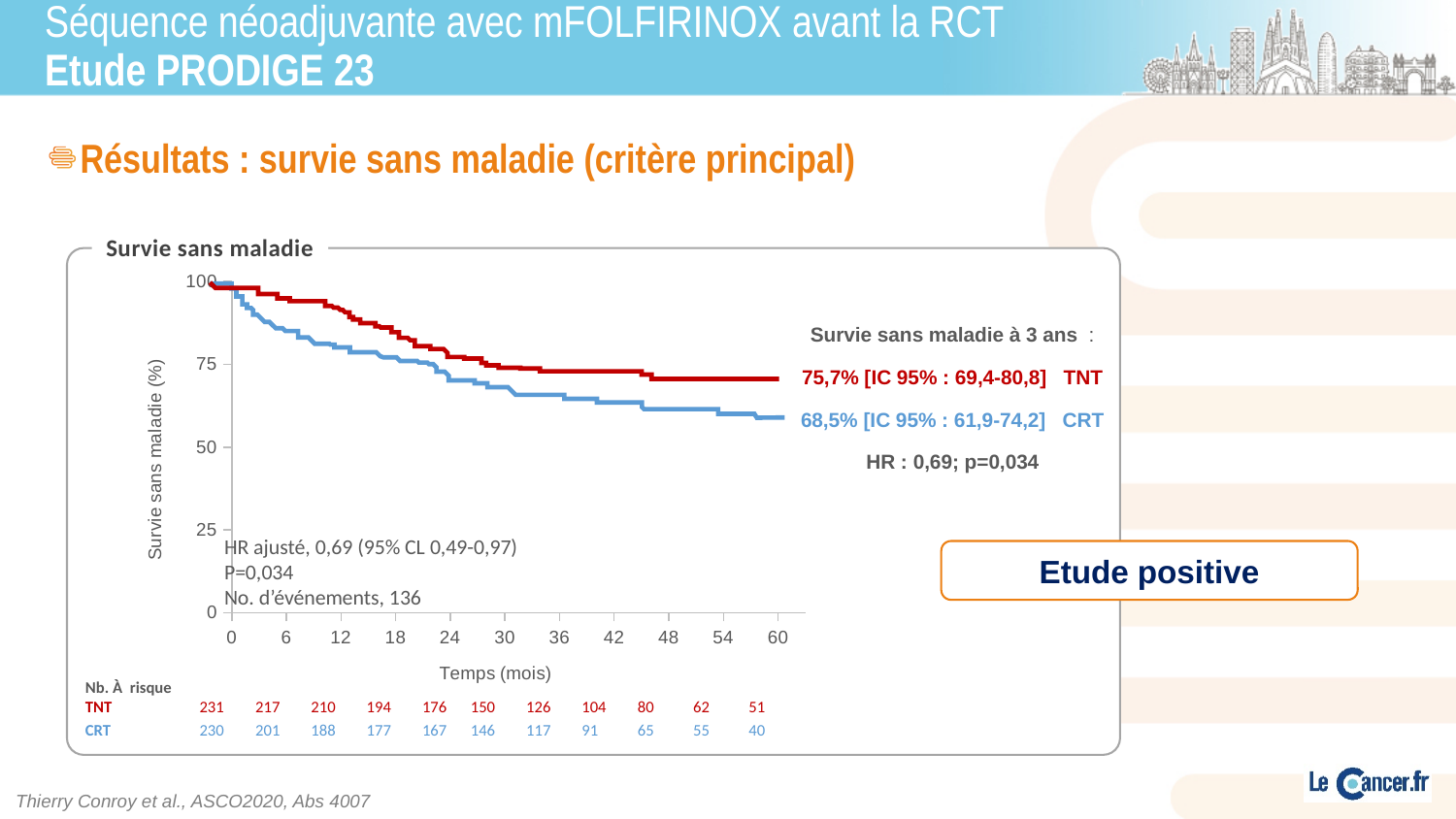
What is the disease-free survival at 3 years for the CRT arm? 68,5% Do the survival curves rise or fall as time (months) increases? fall What colour is the TNT curve? red What kind of chart is shown under the title "Survie sans maladie"? line chart Which arm has the higher disease-free survival at 3 years, TNT or CRT? TNT How many patients were at risk in the CRT arm at 0 months? 230 What is the disease-free survival at 3 years for the TNT arm? 75,7% How many patients were at risk in the CRT arm at 60 months? 40 Is the TNT curve at 60 months greater or less than 50%? greater What is the difference in 3-year disease-free survival between the TNT and CRT arms? 7,2% What is the hazard ratio reported on the chart? 0,69 How many patients were at risk in the TNT arm at 24 months? 176